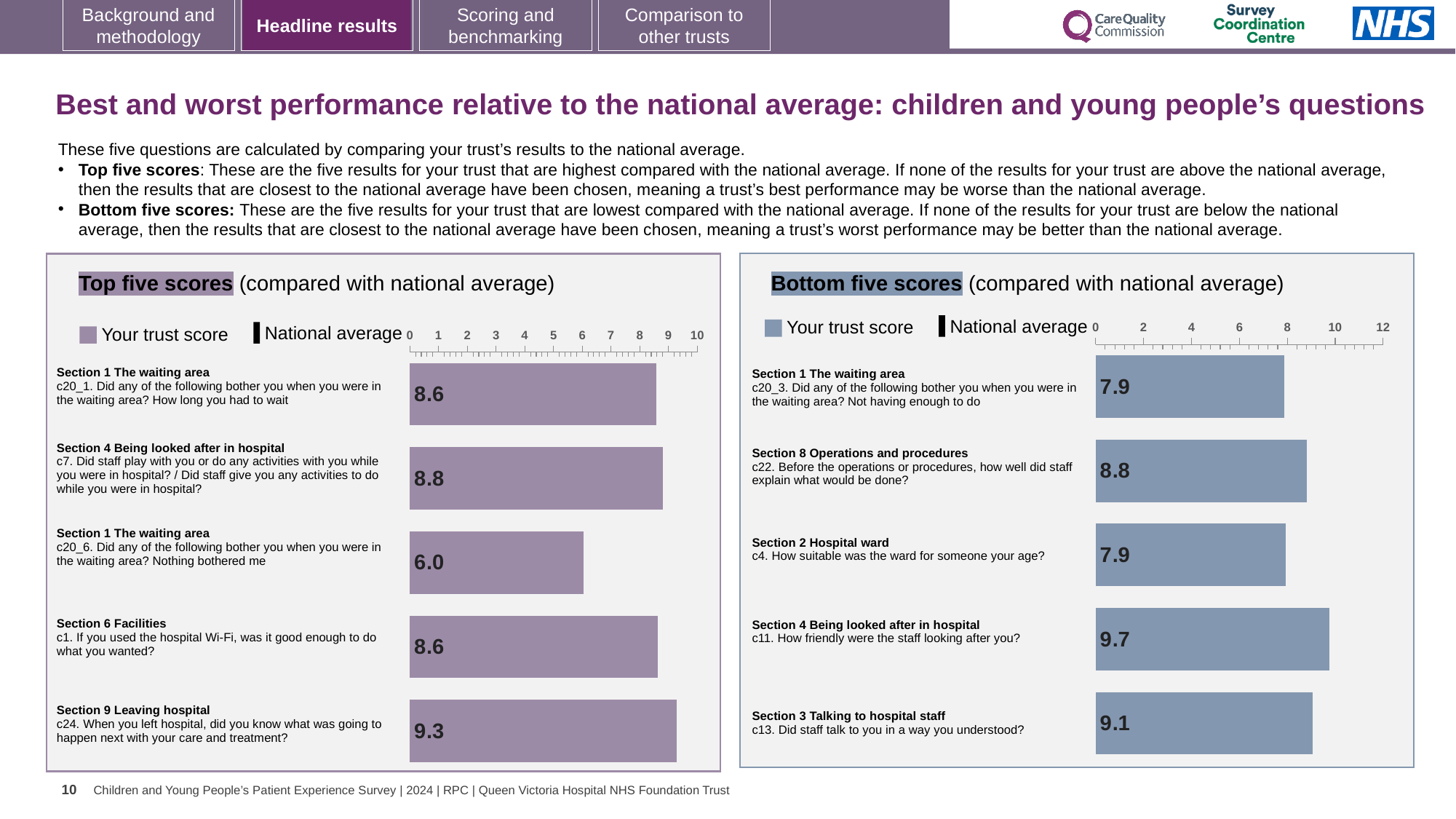
In the Top five scores chart, which question has the lowest trust score? c20_6. Did any of the following bother you when you were in the waiting area? Nothing bothered me In the Top five scores chart, which question has the highest trust score? c24. When you left hospital, did you know what was going to happen next with your care and treatment? In the Top five scores chart, what is the trust score for c24 (When you left hospital, did you know what was going to happen next with your care and treatment?)? 9.3 In the Bottom five scores chart, what is the trust score for c22 (Before the operations or procedures, how well did staff explain what would be done?)? 8.8 How many questions are shown in the Bottom five scores chart? 5 In the Top five scores chart, what is the difference between the trust scores for c24 and c20_6? 3.3 What type of chart is the Top five scores chart? Bar chart In the Bottom five scores chart, which question has the highest trust score? c11. How friendly were the staff looking after you? In the Top five scores chart, what is the trust score for c20_6 (Nothing bothered me in the waiting area)? 6.0 In the Bottom five scores chart, which has the larger trust score: c22 or c4? c22 In the Bottom five scores chart, what is the difference between the trust scores for c11 and c13? 0.6 In the Bottom five scores chart, what is the trust score for c11 (How friendly were the staff looking after you?)? 9.7